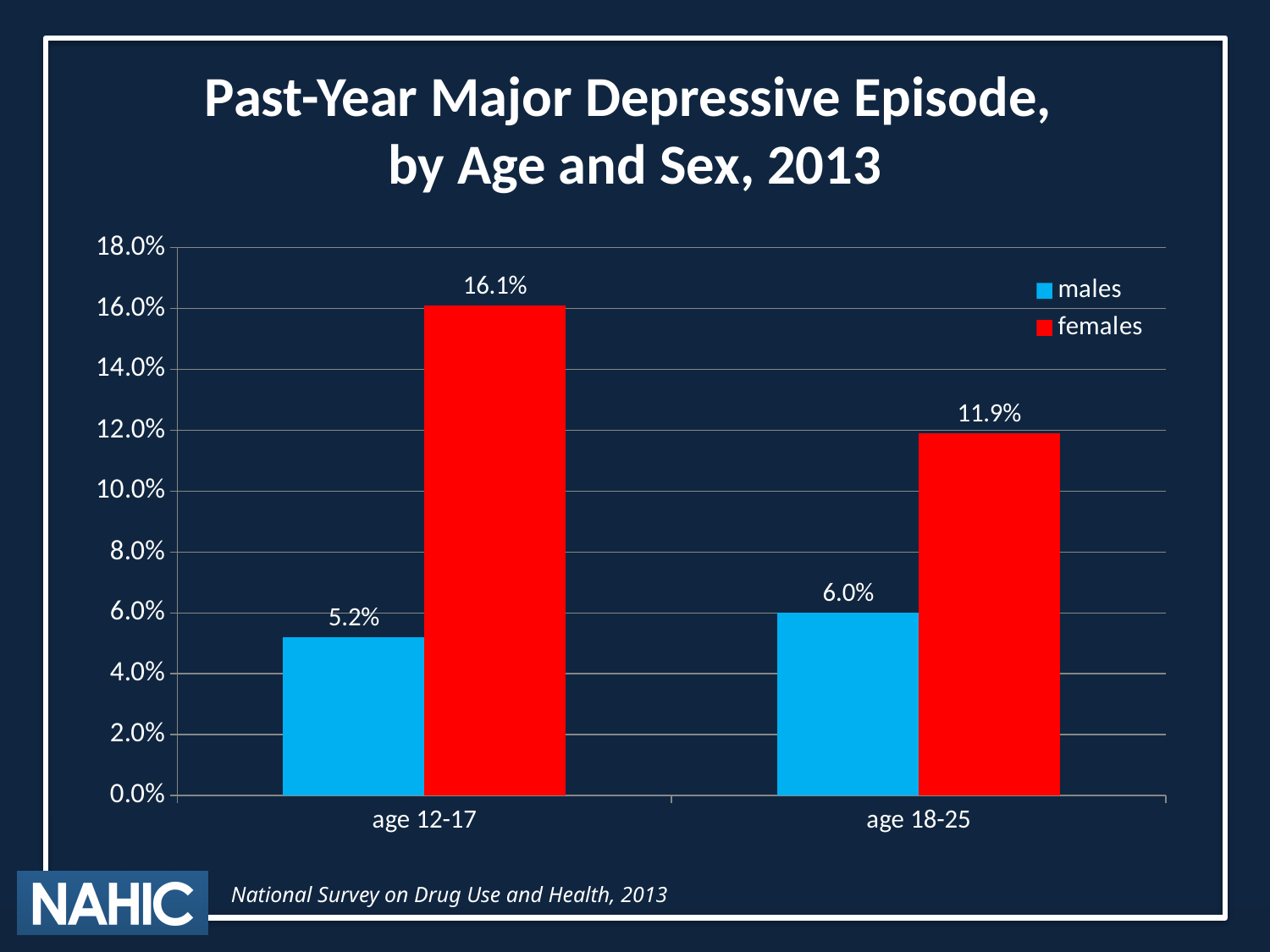
Which bar has the lowest value on the chart? males, age 12-17 Which bar has the highest value on the chart? females, age 12-17 What is the difference between the female values for age 12-17 and age 18-25? 4.2% What is the value for females in the age 12-17 group? 16.1% How many age groups are shown on the x axis? 2 What is the value for males in the age 18-25 group? 6.0% What is the value for females in the age 18-25 group? 11.9% How many series does the legend list? 2 Which is larger, the male value for age 12-17 or the male value for age 18-25? age 18-25 What kind of chart is shown on the slide? bar chart What is the difference between the female and male values in the age 12-17 group? 10.9% What is the value for males in the age 12-17 group? 5.2%